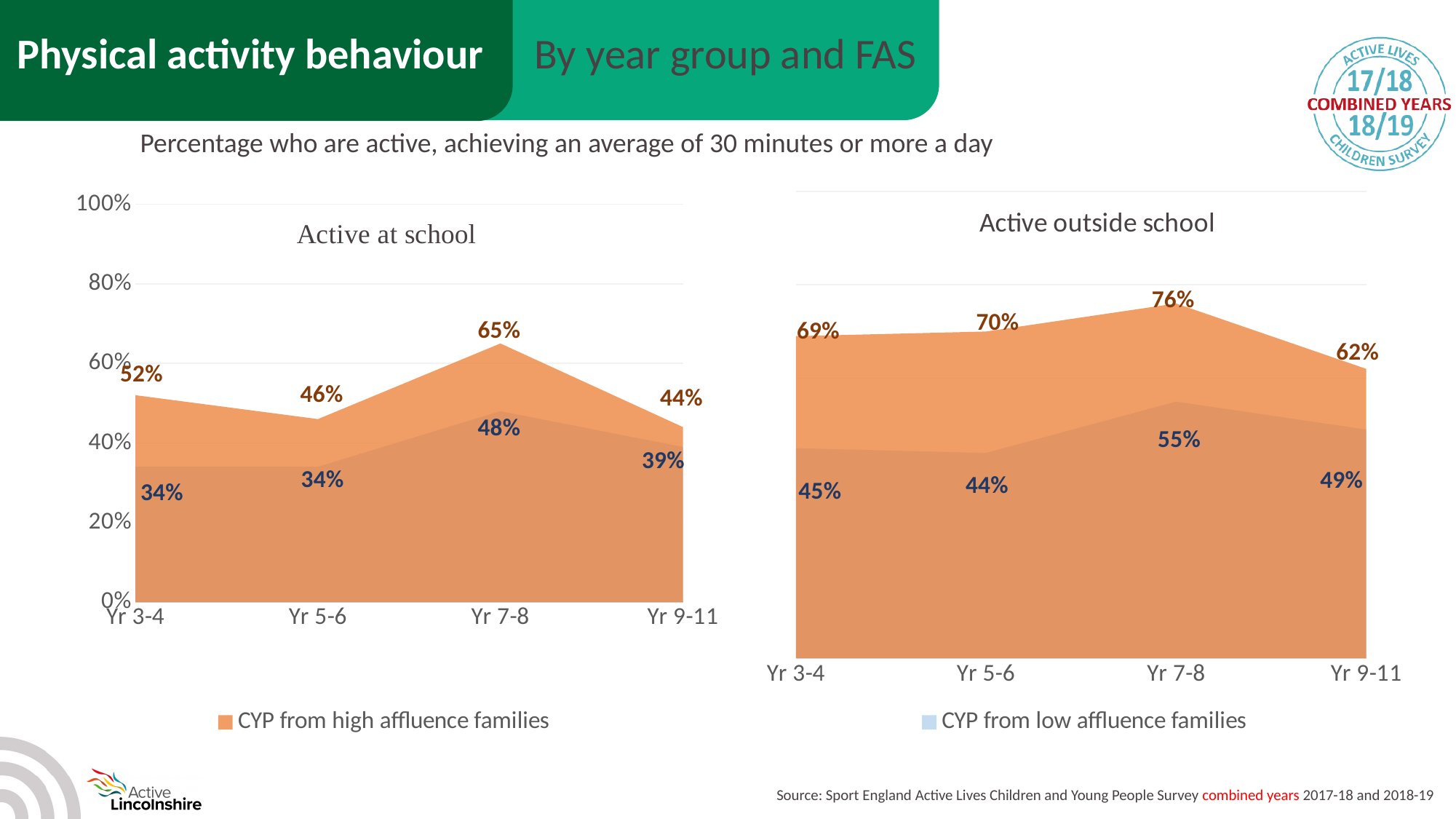
What kind of chart is the 'Active outside school' chart? Area chart How many series does the legend list? 2 In the 'Active outside school' chart, what percentage of CYP from high affluence families in Yr 3-4 are active? 69% In the 'Active at school' chart, which year group has the lowest value for CYP from high affluence families? Yr 9-11 In the 'Active at school' chart, what percentage of CYP from high affluence families in Yr 7-8 are active? 65% In the 'Active outside school' chart, what percentage of CYP from low affluence families in Yr 7-8 are active? 55% In the 'Active outside school' chart, which is larger for Yr 5-6: CYP from high affluence families or CYP from low affluence families? CYP from high affluence families In the 'Active at school' chart, what percentage of CYP from low affluence families in Yr 9-11 are active? 39% In the 'Active at school' chart, what is the difference between high affluence and low affluence families in Yr 7-8? 17 percentage points In the 'Active outside school' chart, which year group has the highest value for CYP from high affluence families? Yr 7-8 How many year groups are shown on the x axis of the 'Active at school' chart? 4 In the 'Active outside school' chart, what is the difference between high affluence and low affluence families in Yr 9-11? 13 percentage points